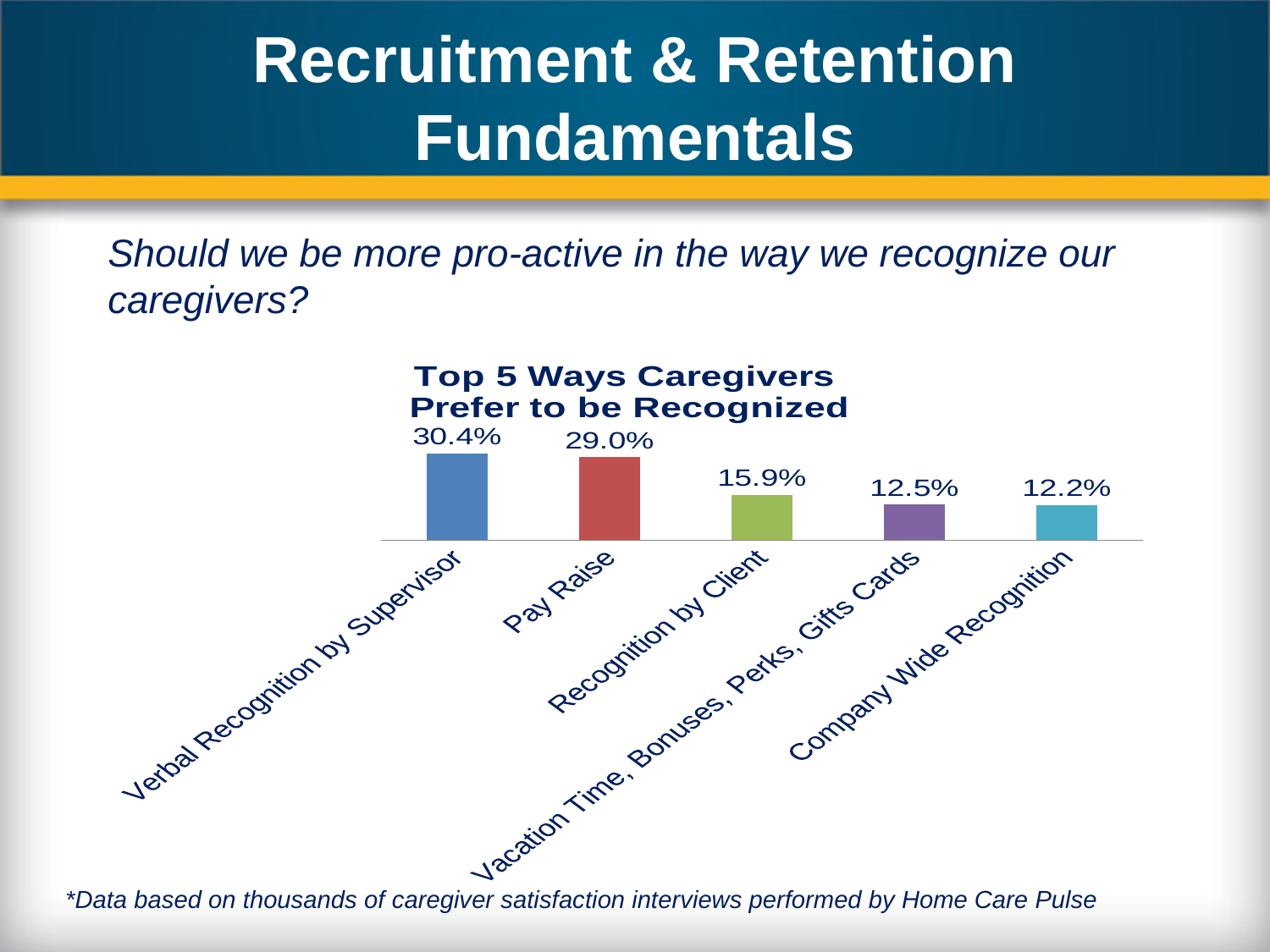
What is the value for Pay Raise? 29.0% What is the value for Recognition by Client? 15.9% How many categories are shown in the chart? 5 What is the difference between the values for Verbal Recognition by Supervisor and Pay Raise? 1.4% What is the value for Vacation Time, Bonuses, Perks, Gifts Cards? 12.5% What is the value for Company Wide Recognition? 12.2% What is the difference between the values for Pay Raise and Recognition by Client? 13.1% Which category has the lowest value? Company Wide Recognition What is the value for Verbal Recognition by Supervisor? 30.4% Which category has the highest value? Verbal Recognition by Supervisor What is the title of the chart? Top 5 Ways Caregivers Prefer to be Recognized Which is larger, the value for Pay Raise or the value for Recognition by Client? Pay Raise